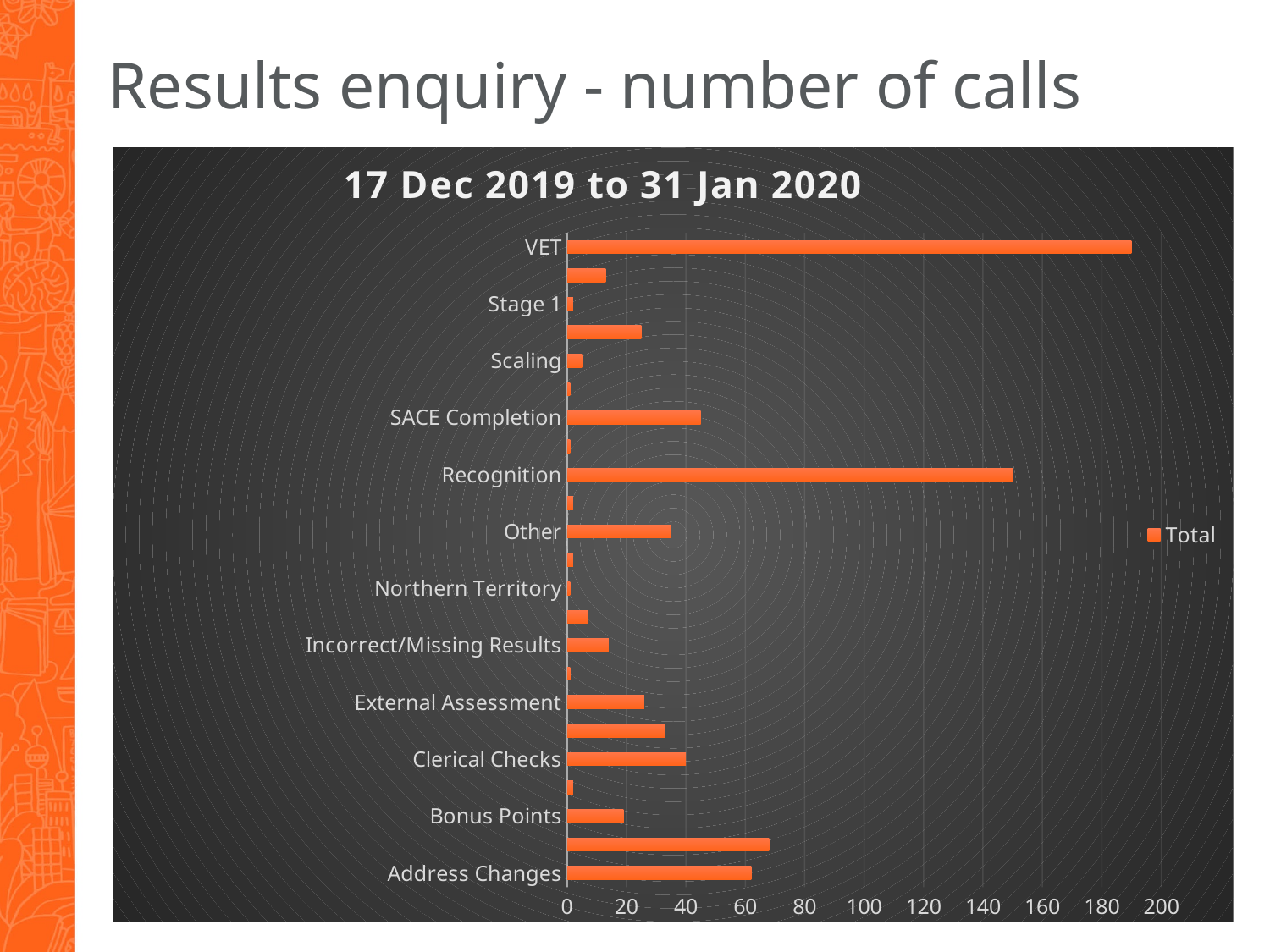
Which has more calls, VET or Recognition? VET Is the value for Address Changes greater or less than 40? greater Which has more calls, SACE Completion or Bonus Points? SACE Completion How many series does the legend list? 1 Is the value for Other greater or less than 40? less Is the value for Incorrect/Missing Results greater or less than 20? less What is the name of the series shown in the legend? Total What kind of chart is shown on the slide? bar chart What is the title of the chart? 17 Dec 2019 to 31 Jan 2020 Which labelled category has the highest number of calls? VET